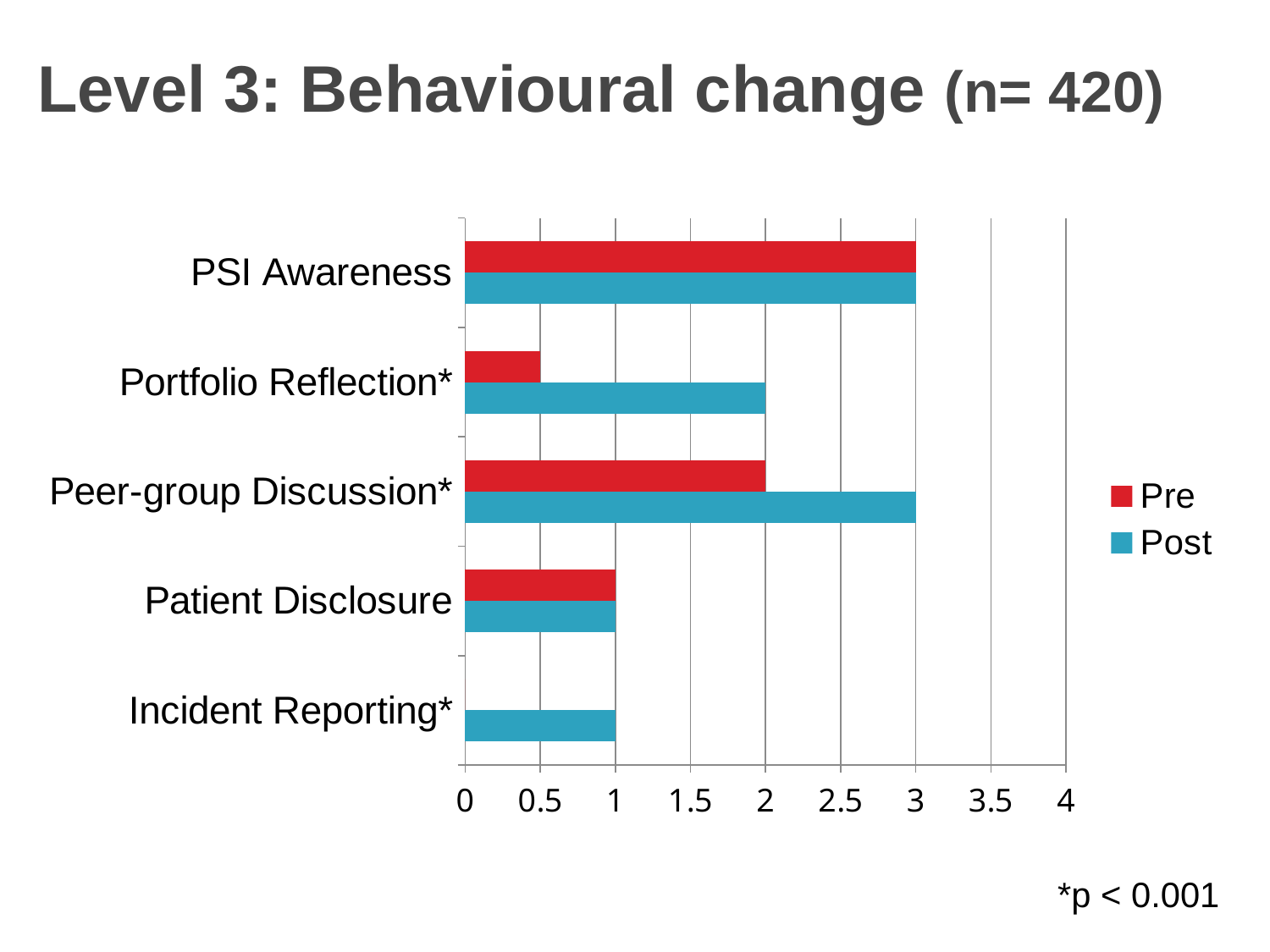
Which colour represents the Post series in the legend? blue Which category has the lowest Pre value? Incident Reporting* How many series does the legend list? 2 Which is larger for Peer-group Discussion*, the Pre value or the Post value? Post How many categories are shown on the chart? 5 What is the Post value for Incident Reporting*? 1 What is the Post value for Portfolio Reflection*? 2 What is the Pre value for Portfolio Reflection*? 0.5 Is the Pre value for Peer-group Discussion* greater or less than 1.5? greater What kind of chart is shown on the slide? bar chart What is the difference between the Post and Pre values for Portfolio Reflection*? 1.5 What is the Post value for Peer-group Discussion*? 3